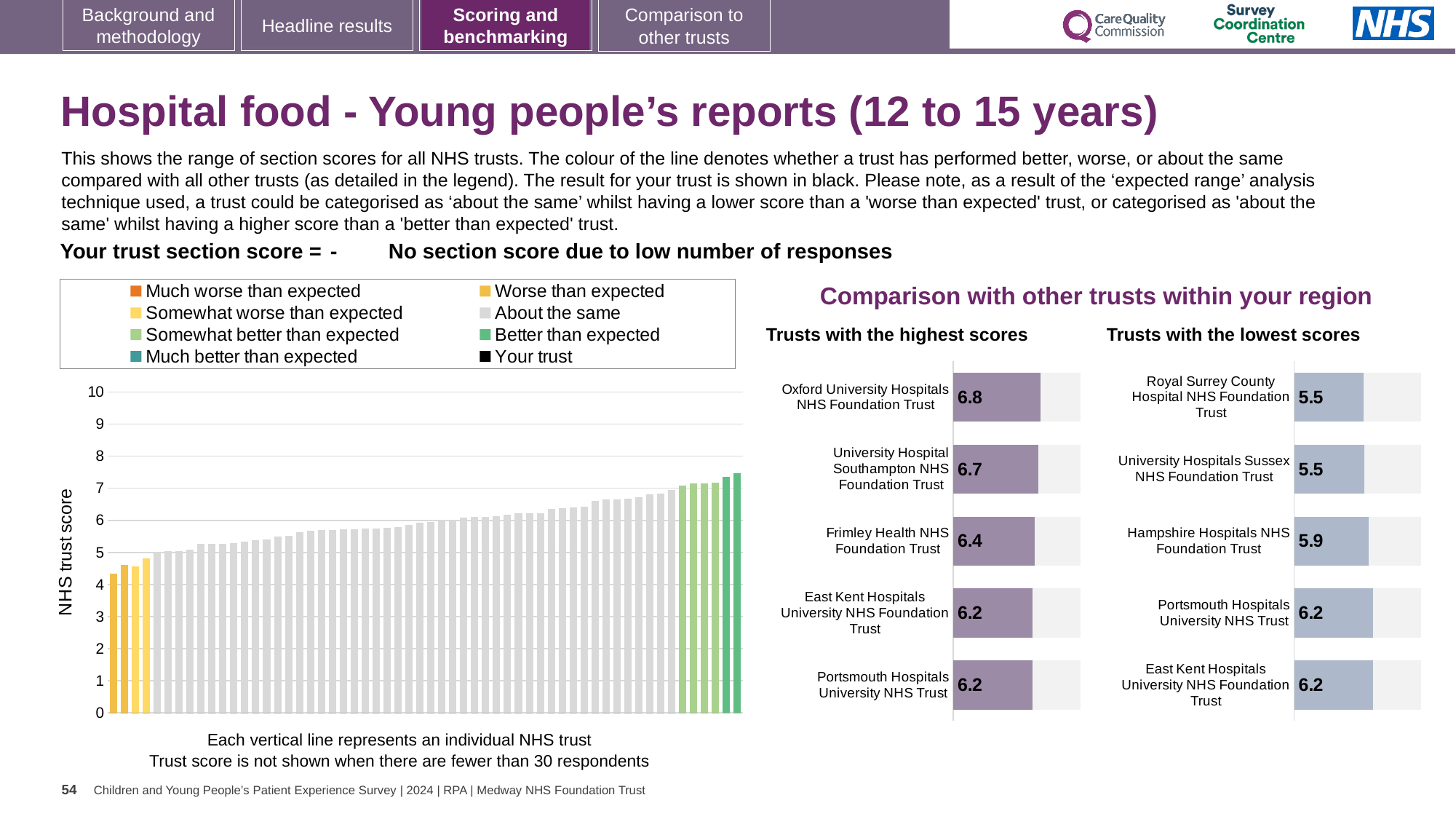
In the 'NHS trust score' chart on the left, is the value of the leftmost bar greater or less than 5? less What kind of chart is the 'NHS trust score' chart on the left of the slide? Bar chart In the 'Trusts with the highest scores' chart, what is the score for Frimley Health NHS Foundation Trust? 6.4 How many trusts are listed in the 'Trusts with the highest scores' chart? 5 In the 'Trusts with the highest scores' chart, what is the score for Oxford University Hospitals NHS Foundation Trust? 6.8 In the 'Trusts with the highest scores' chart, which trust has the highest score? Oxford University Hospitals NHS Foundation Trust In the 'NHS trust score' chart on the left, do the bar values rise or fall from left to right? Rise In the 'Trusts with the lowest scores' chart, what is the lowest score shown? 5.5 In the 'Trusts with the lowest scores' chart, what is the score for Hampshire Hospitals NHS Foundation Trust? 5.9 In the 'Trusts with the highest scores' chart, what is the difference between the scores of Oxford University Hospitals NHS Foundation Trust and University Hospital Southampton NHS Foundation Trust? 0.1 In the 'Trusts with the lowest scores' chart, how much higher is the score for Hampshire Hospitals NHS Foundation Trust than for Royal Surrey County Hospital NHS Foundation Trust? 0.4 Which has the larger score: Frimley Health NHS Foundation Trust in the 'highest scores' chart or Hampshire Hospitals NHS Foundation Trust in the 'lowest scores' chart? Frimley Health NHS Foundation Trust